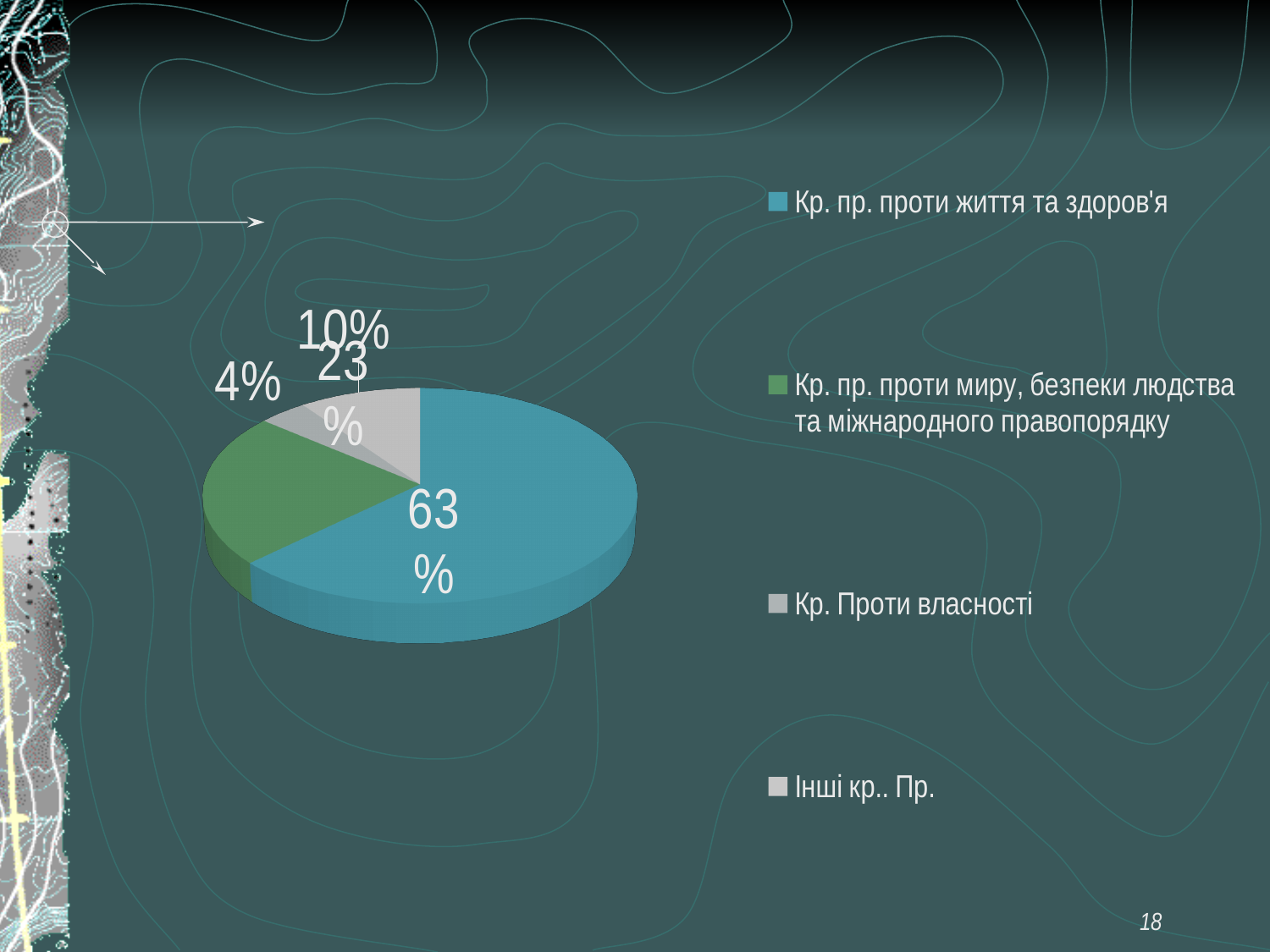
What kind of chart is shown on the slide? pie chart Which category has the largest slice of the pie? Кр. пр. проти життя та здоров'я What share of the pie does "Кр. пр. проти життя та здоров'я" have? 63% What is the value shown for "Кр. пр. проти миру, безпеки людства та міжнародного правопорядку"? 23% Which category has the smallest slice of the pie? Кр. Проти власності How many entries does the legend list? 4 Which is larger: the slice for "Інші кр.. Пр." or the slice for "Кр. Проти власності"? Інші кр.. Пр. What colour is the slice for "Кр. пр. проти життя та здоров'я"? blue What is the value shown for "Кр. Проти власності"? 4% How many slices does the pie chart have? 4 What is the value shown for "Інші кр.. Пр."? 10% What is the difference between the share for "Кр. пр. проти життя та здоров'я" and the share for "Кр. пр. проти миру, безпеки людства та міжнародного правопорядку"? 40%